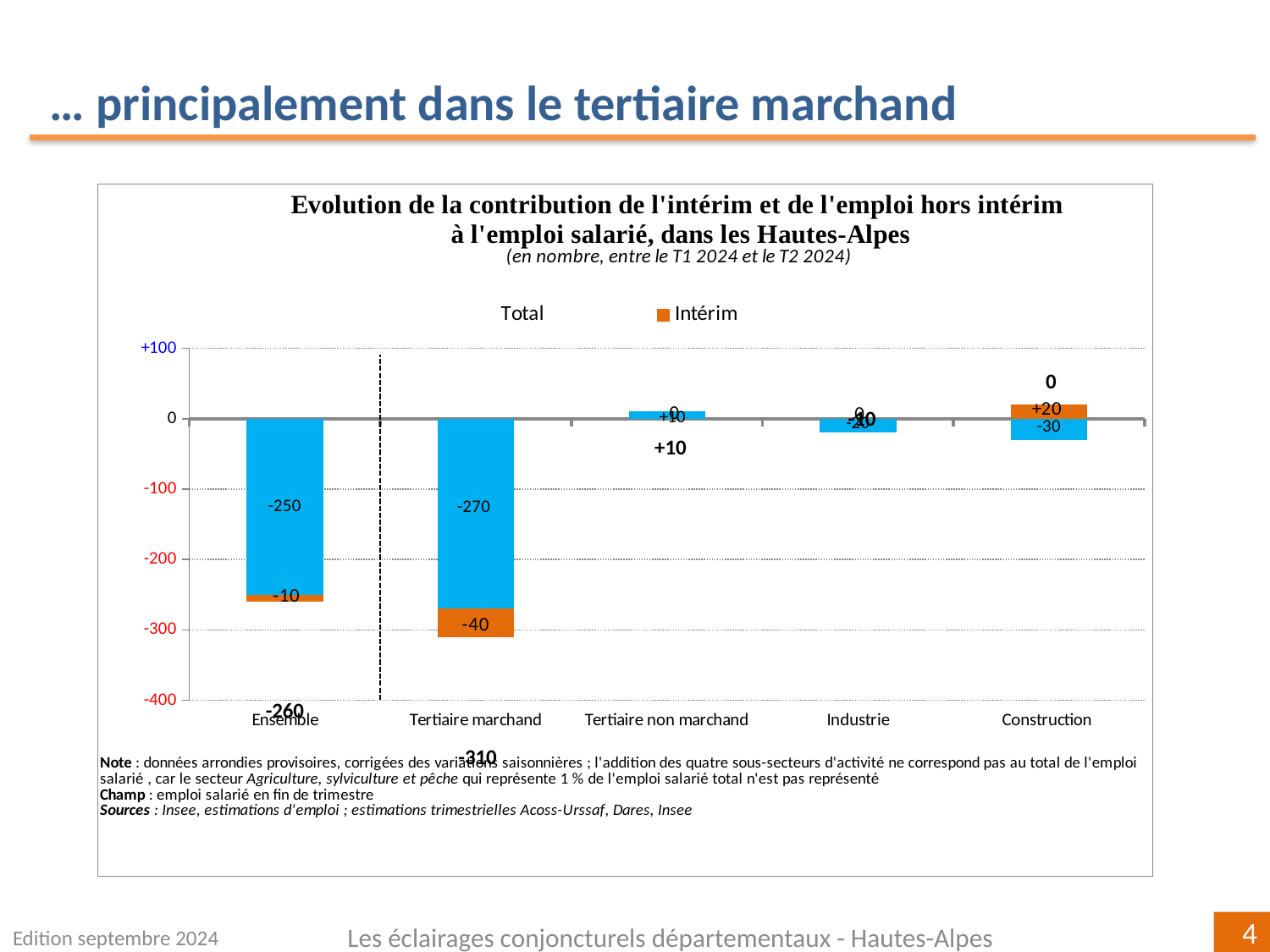
Which has the larger Intérim value, Construction or Tertiaire marchand? Construction How many series does the chart legend list? 2 What is the value of the blue (non-intérim) bar for Tertiaire marchand? -270 What is the Intérim value for Tertiaire marchand? -40 What is the difference between the blue bar values for Ensemble (-250) and Tertiaire marchand (-270)? 20 What is the Intérim value for Ensemble? -10 What kind of chart is shown on the slide? bar chart What is the total (bold label) for Tertiaire marchand? -310 What is the Intérim value for Construction? +20 Which sector has the lowest total value? Tertiaire marchand What is the total (bold label) for Ensemble? -260 How many sectors (categories) are shown along the x axis of the chart? 5